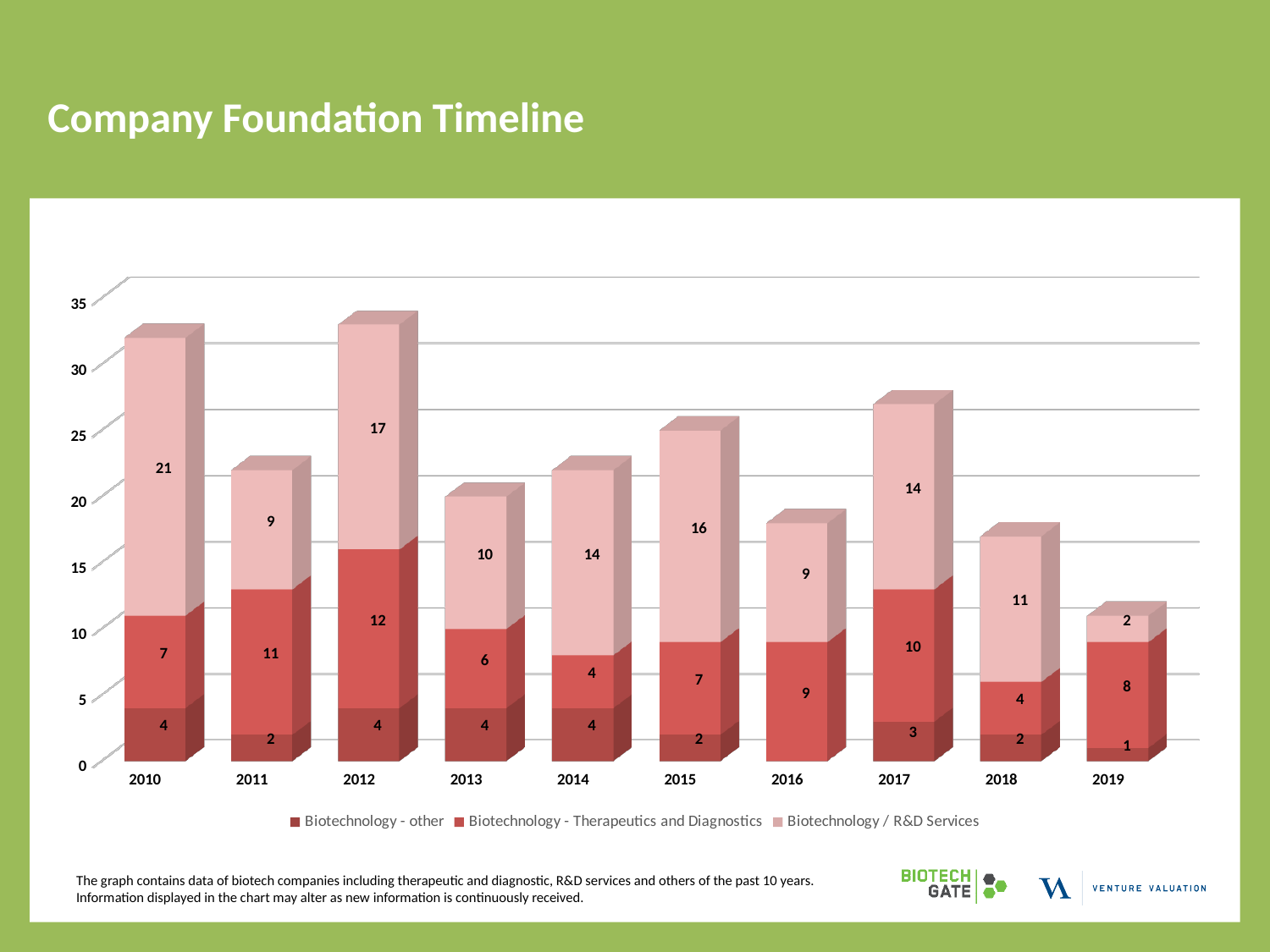
Which year has the larger Biotechnology - Therapeutics and Diagnostics value, 2015 or 2017? 2017 How many years are shown on the x axis of the chart? 10 In which year is the Biotechnology / R&D Services value lowest? 2019 What kind of chart is shown on the slide? Stacked bar chart How many series does the legend list? 3 What is the value for Biotechnology - Therapeutics and Diagnostics in 2012? 12 What is the total of the stacked bar for 2019? 11 In which year is the Biotechnology / R&D Services value highest? 2010 What is the difference between the Biotechnology / R&D Services values for 2010 and 2019? 19 What is the value for Biotechnology / R&D Services in 2010? 21 What is the value for Biotechnology - other in 2017? 3 What is the total of the stacked bar for 2012? 33